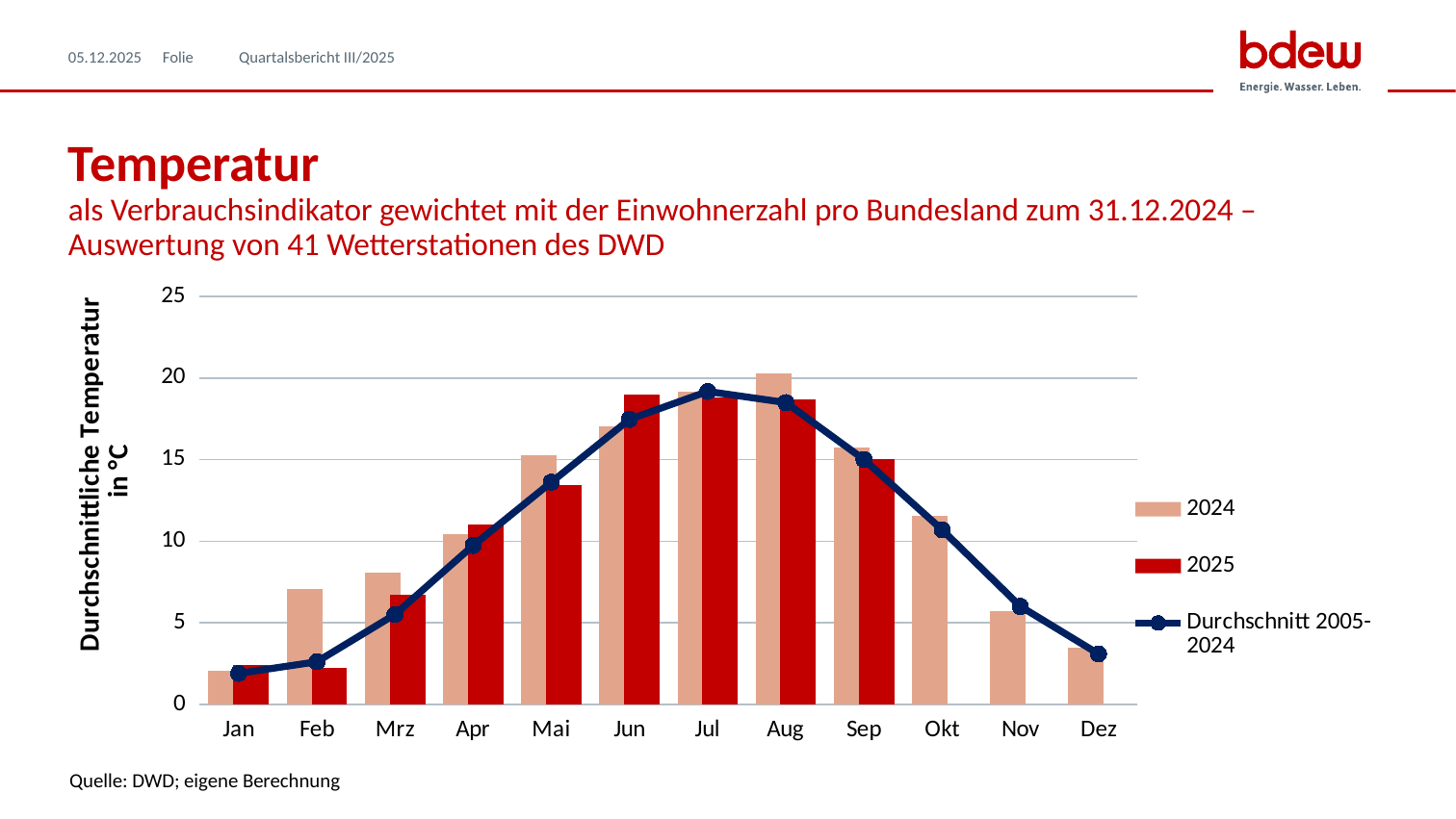
In which month is the 2024 value lowest? Jan For how many months is a 2025 bar shown? 9 Is the 2025 value for Mai greater or less than 15? less For Jun, which is larger: the 2024 value or the 2025 value? 2025 In which month is the 2024 value highest? Aug What kind of chart is shown on the slide? A bar chart combined with a line chart Do the 2024 values rise or fall from Jan to Aug? rise How many months are shown on the x axis? 12 How many series does the legend list? 3 For Feb, which is larger: the 2024 value or the 2025 value? 2024 Is the 2024 value for Nov greater or less than 10? less What is the label of the y axis? Durchschnittliche Temperatur in °C